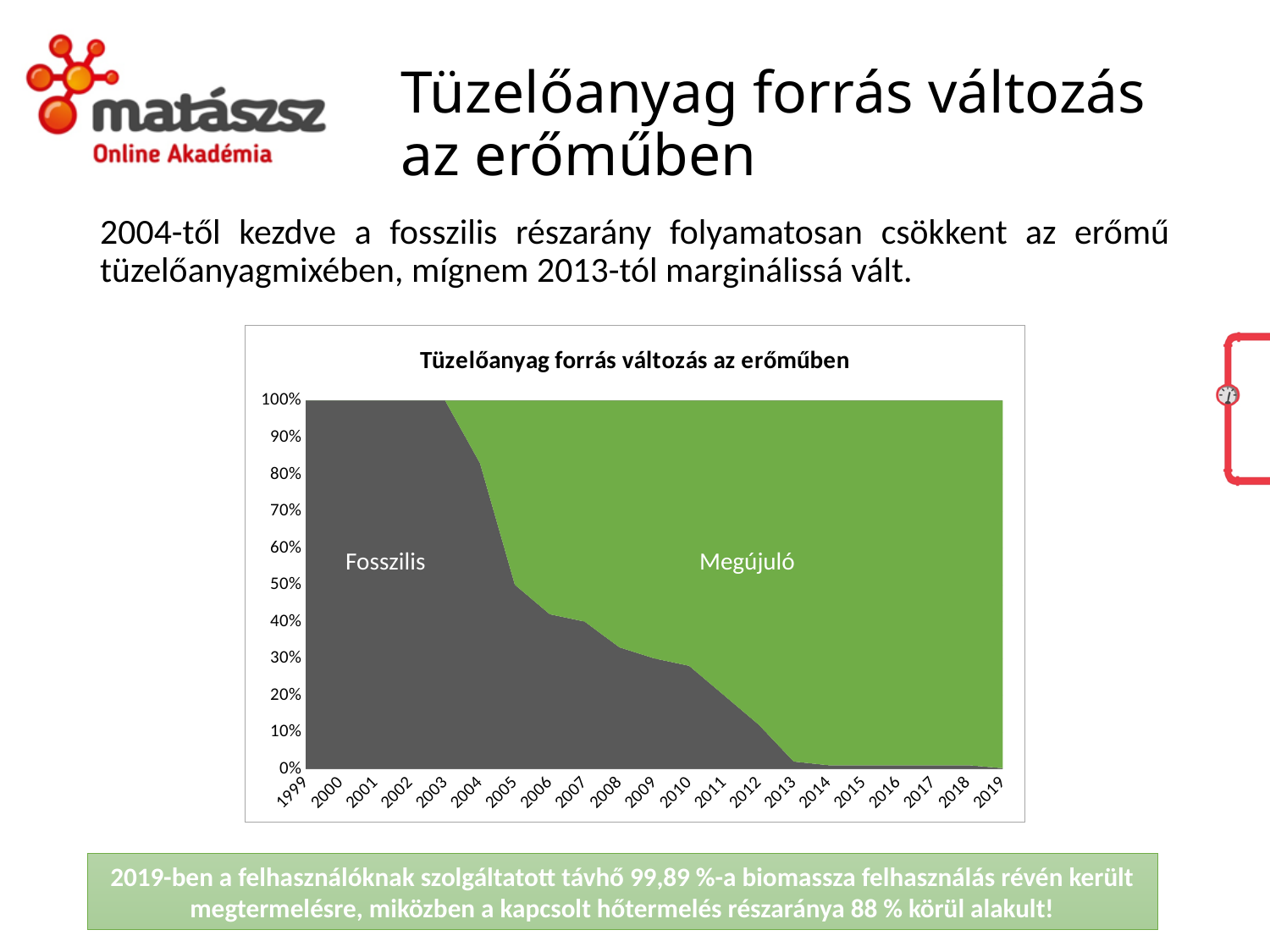
What is the title of the chart? Tüzelőanyag forrás változás az erőműben In 2002, which series has the larger share, Fosszilis or Megújuló? Fosszilis What kind of chart is shown on the slide? area chart Is the share of Fosszilis in 2013 greater or less than 10%? less In 2008, which series has the larger share, Fosszilis or Megújuló? Megújuló Is the share of Fosszilis in 2004 greater or less than 70%? greater Is the share of Megújuló in 2015 greater or less than 90%? greater Does the share of Fosszilis rise or fall from 2003 to 2013? fall How many years are shown on the x axis of the chart? 21 Which colour represents the Megújuló series in the chart? green How many series does the chart show? 2